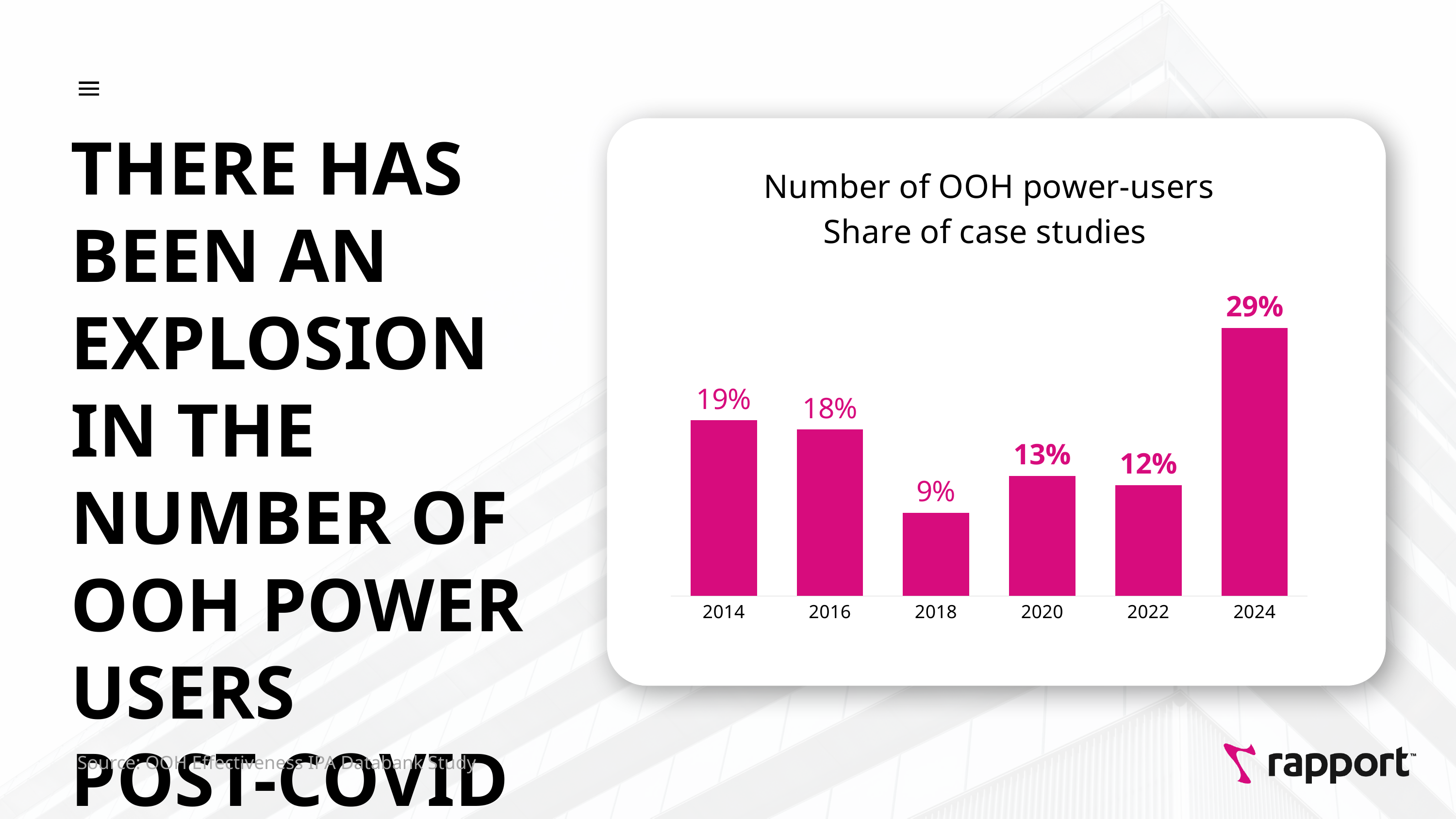
What is the difference between the values for 2024 and 2022? 17% What is the share of case studies for 2024? 29% Which is larger, the value for 2020 or the value for 2016? 2016 Which year has the lowest share of case studies? 2018 Which year has the highest share of case studies? 2024 What is the value shown for 2022? 12% What is the title of the chart? Number of OOH power-users Share of case studies What is the value shown for 2014? 19% How many years are shown on the x axis of the chart? 6 What is the share of case studies for 2018? 9% What is the difference between the values for 2014 and 2018? 10% What kind of chart is shown on the slide? Bar chart